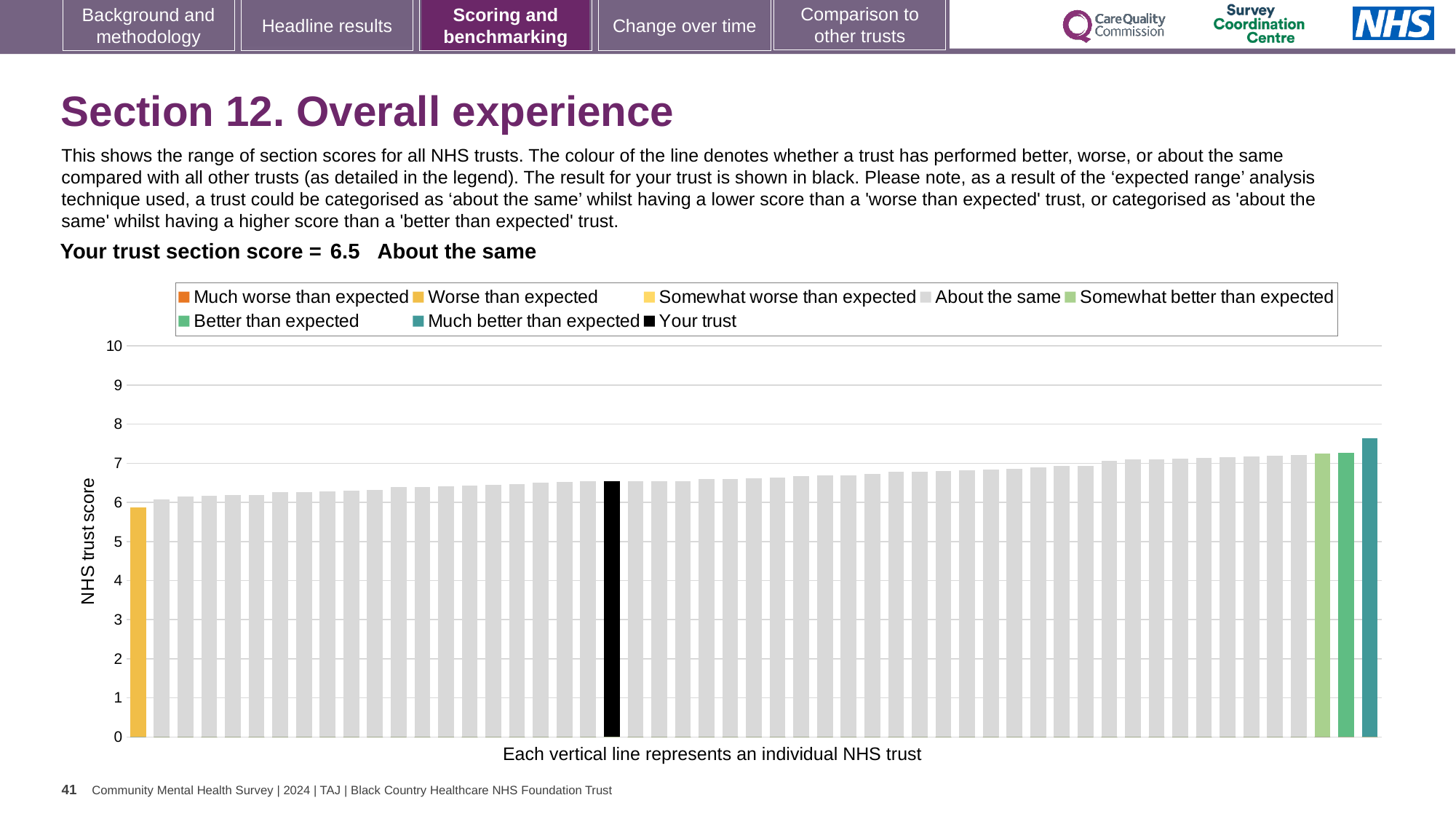
What is the highest value shown on the vertical axis? 10 What is the label on the vertical axis of the chart? NHS trust score What is your trust's section score for Section 12, Overall experience? 6.5 What kind of chart is shown on the slide? bar chart Which performance category does the highest-scoring trust (rightmost bar) fall into, according to the legend colours? Much better than expected Is the value of the black bar for your trust greater or less than 6? greater Which performance category does the lowest-scoring trust (leftmost bar) fall into, according to the legend colours? Worse than expected Do the trust scores rise or fall from left to right along the x axis? rise How is your trust categorised compared with other trusts in Section 12? About the same Is the value of the black bar for your trust greater or less than 7? less How many entries does the chart legend list? 8 Is the value of the tallest bar (the rightmost trust) greater or less than 7? greater